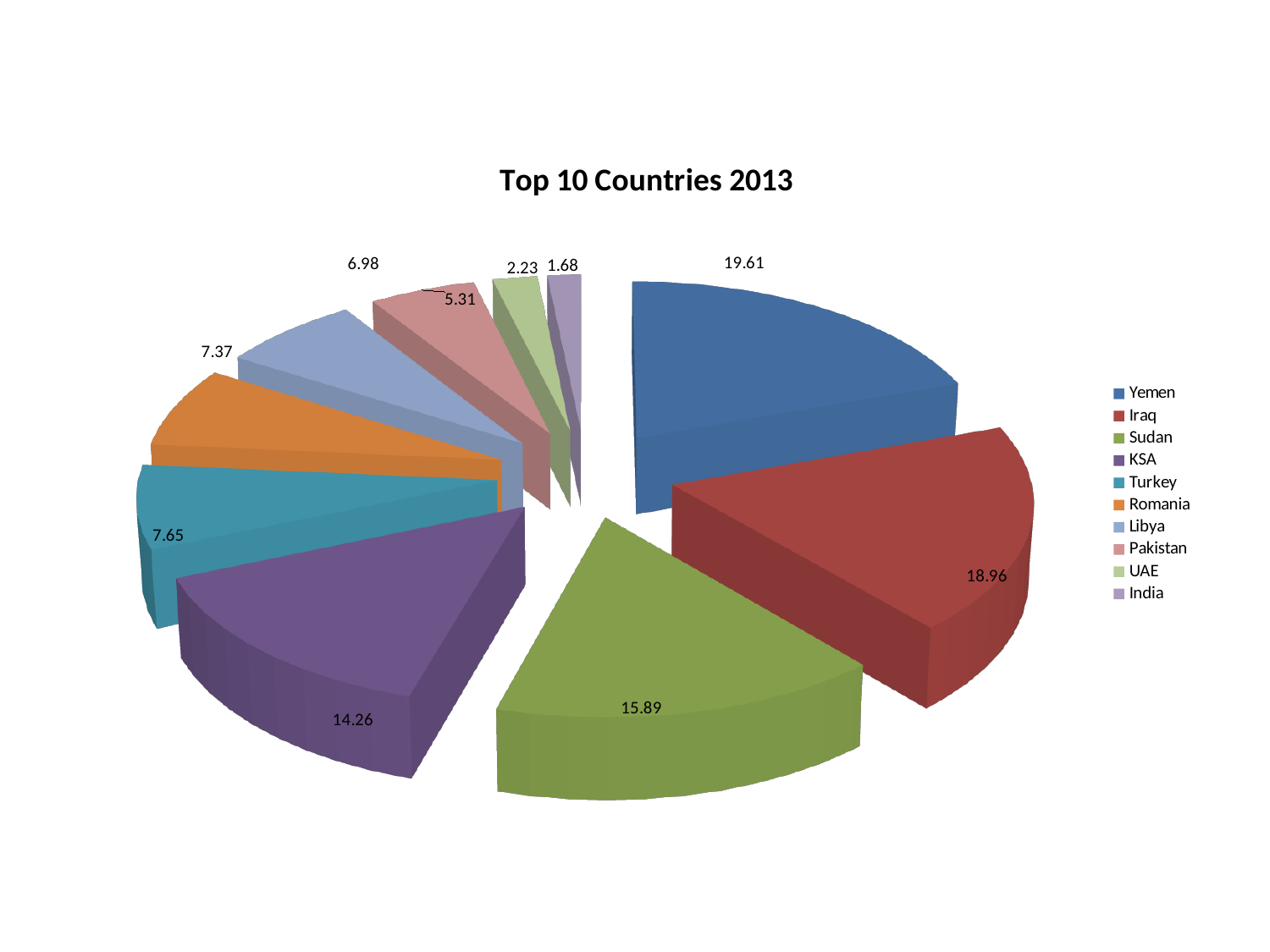
What is the value shown for Iraq? 18.96 What is the difference between the values for Sudan and KSA? 1.63 What is the value shown for Pakistan? 5.31 Which has the larger value, Romania or Libya? Romania Which country has the smallest slice of the pie? India What is the value shown for KSA? 14.26 How many countries are shown in the pie chart? 10 What type of chart is shown on the slide? Pie chart What is the difference between the values for Yemen and Iraq? 0.65 What is the value shown for Yemen? 19.61 What is the value shown for India? 1.68 Which country has the largest slice of the pie? Yemen